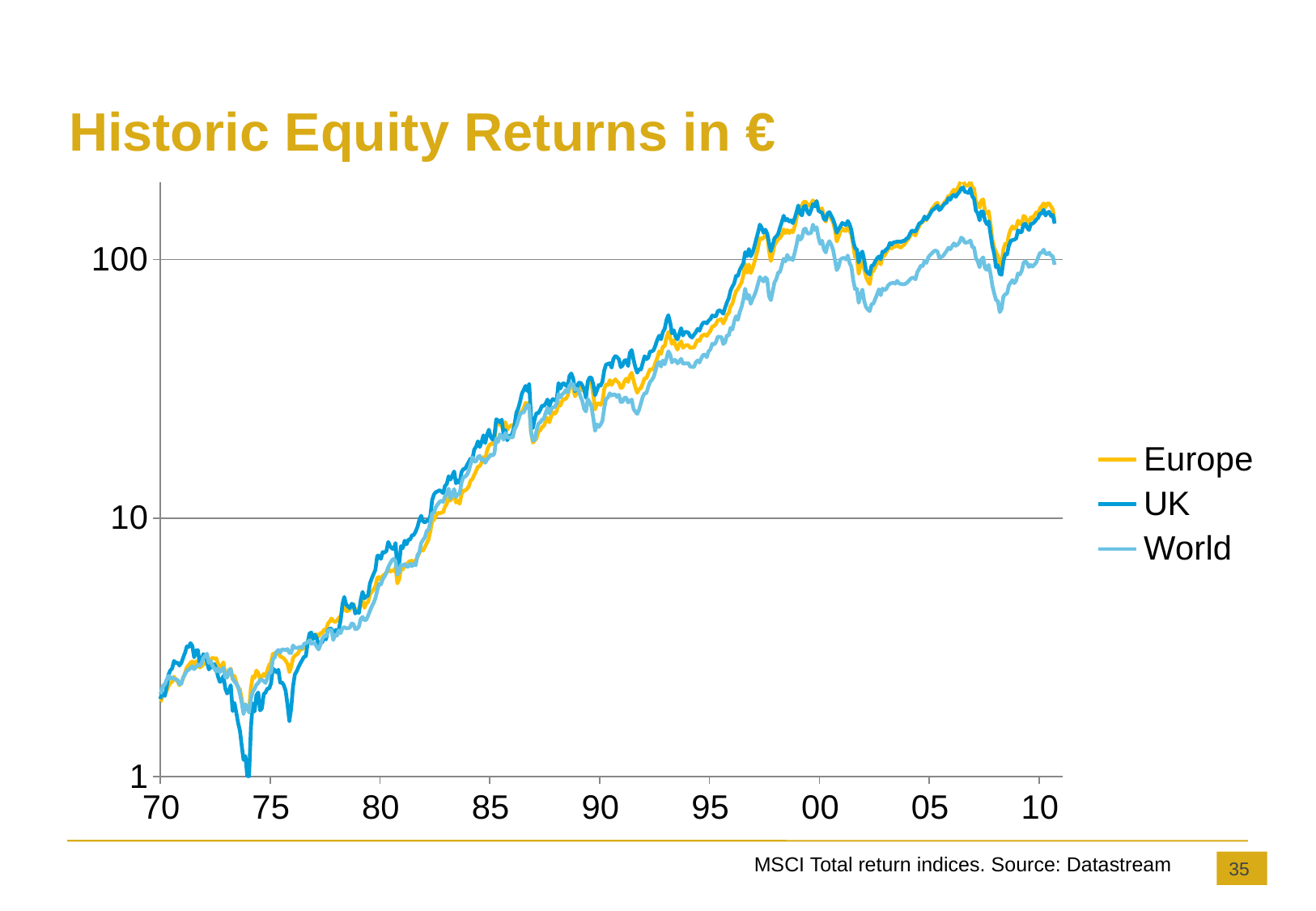
Which series is lowest at the 2008 trough? World Overall, do the index values rise or fall from 1970 to 2010? rise What is the title of the chart? Historic Equity Returns in € Is the value of the World series at its 2008 low greater or less than 100? less Which series is drawn in yellow? Europe Which series falls lowest around 1974? UK Is the value of the Europe series around 1985 greater or less than 10? greater At the right end of the chart (2010), which is higher, the Europe series or the World series? Europe Is the value of the UK series around 1980 greater or less than 10? less How many series does the legend list? 3 What kind of chart is shown on the slide? line chart